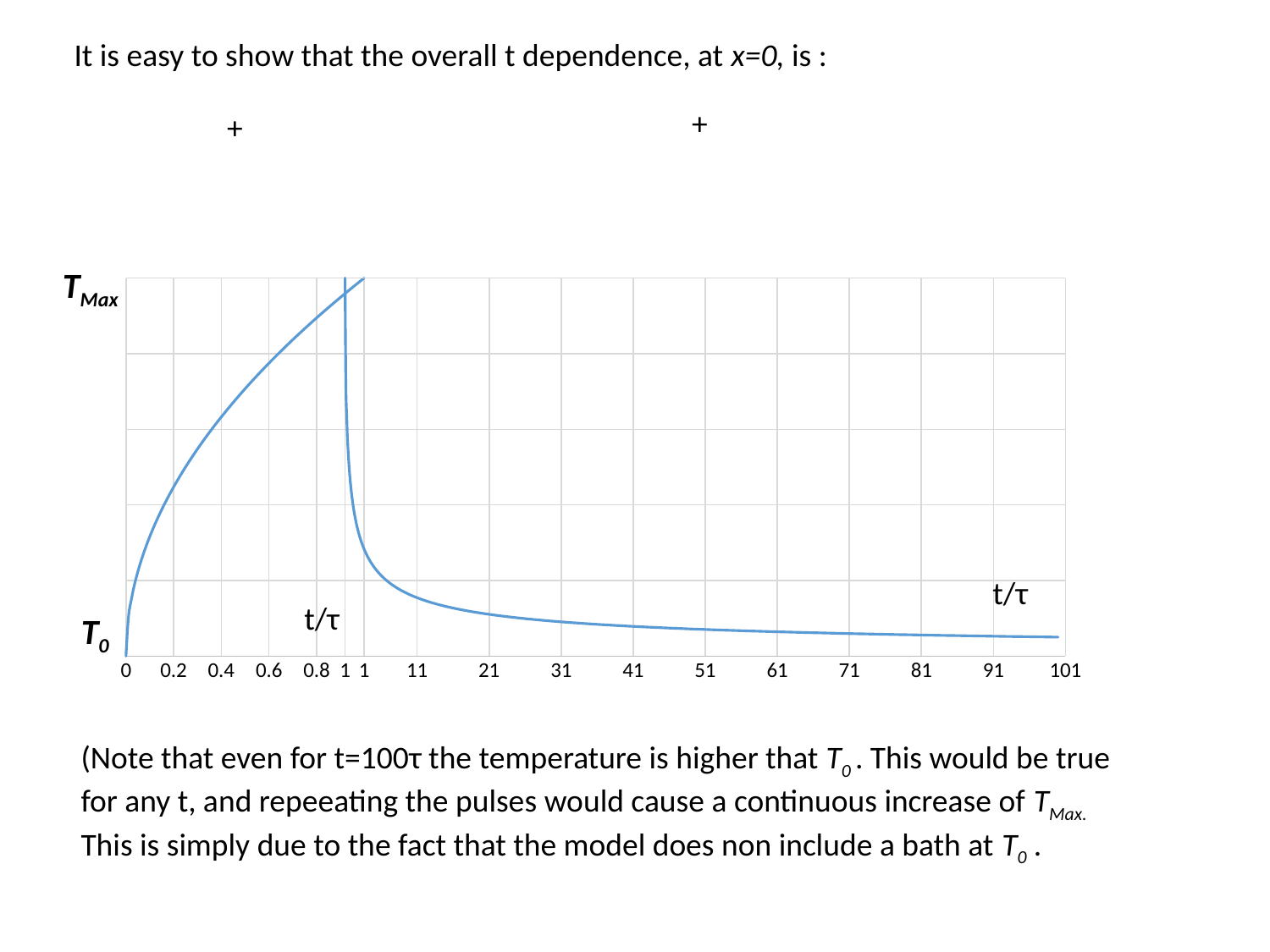
At which x-axis value does the curve reach its highest point? 1 What label is shown on the x axis of the chart? t/τ What kind of chart is shown on the slide? line chart What label marks the top of the y axis of the chart? TMax At which x-axis value is the curve at its lowest point? 0 In the right part of the chart (t/τ from 1 to 101), does the curve rise or fall as t/τ increases? falls Is the curve value at t/τ = 11 higher or lower than at t/τ = 91? higher Is the curve value at t/τ = 0.2 higher or lower than at t/τ = 0.8? lower In the left part of the chart (t/τ from 0 to 1), does the curve rise or fall as t/τ increases? rises What is the largest tick label on the x axis of the right part of the chart? 101 What is the largest tick label on the x axis of the left part of the chart? 1